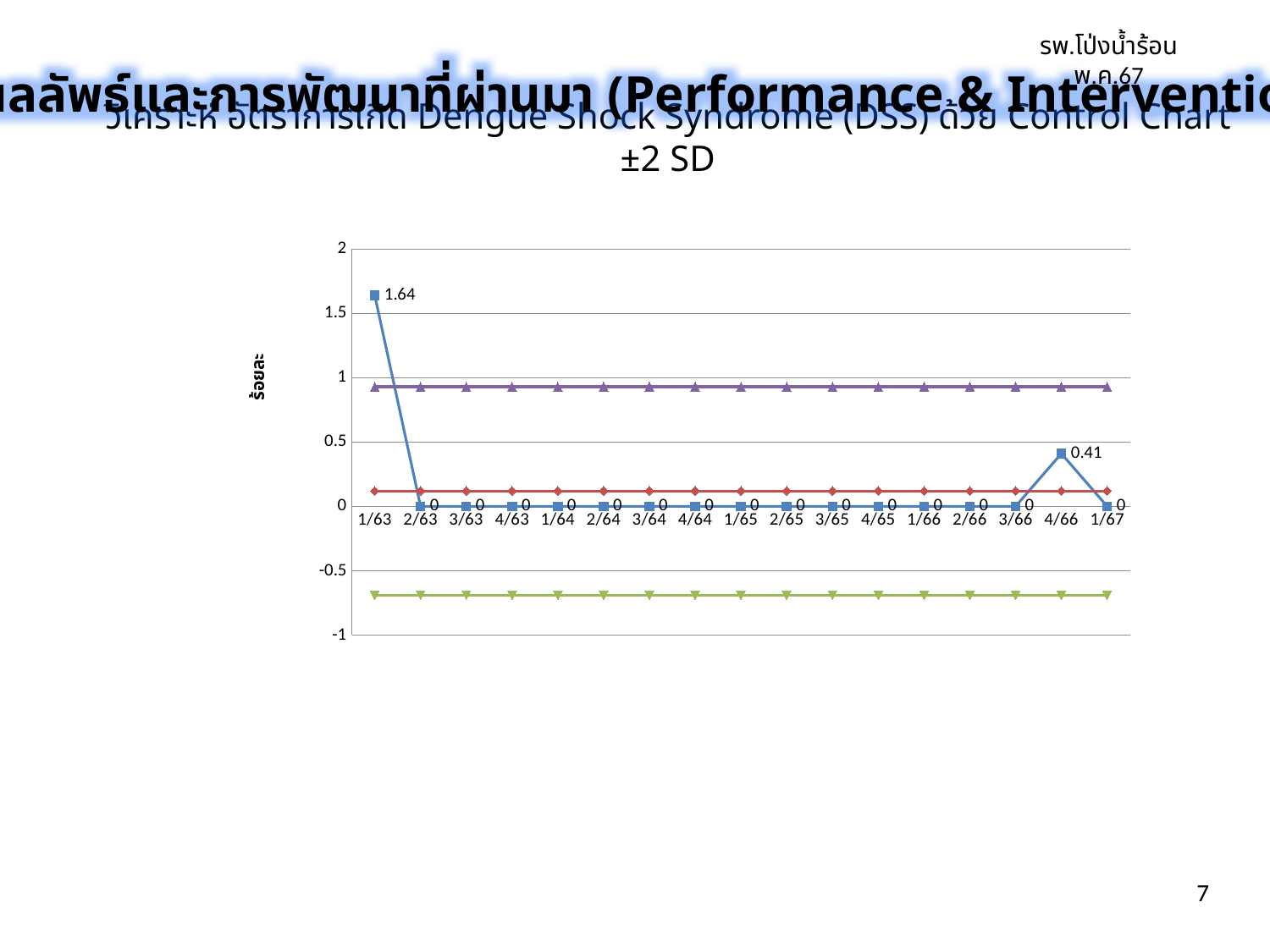
How many periods are shown on the x axis? 17 What is the value of the data series at 4/66? 0.41 Is the upper control limit line (purple, with triangle markers) greater or less than 1? less What is the value of the data series at 1/67? 0 What is the value of the data series at 1/63? 1.64 At which period does the data series reach its highest value? 1/63 Which is larger, the value at 1/63 or the value at 4/66? 1/63 What is the label of the y axis? ร้อยละ Is the lower control limit line (green, with inverted triangle markers) greater or less than -0.5? less What kind of chart is shown on the slide? line chart What is the difference between the values at 1/63 and 4/66? 1.23 What is the value of the data series at 2/63? 0